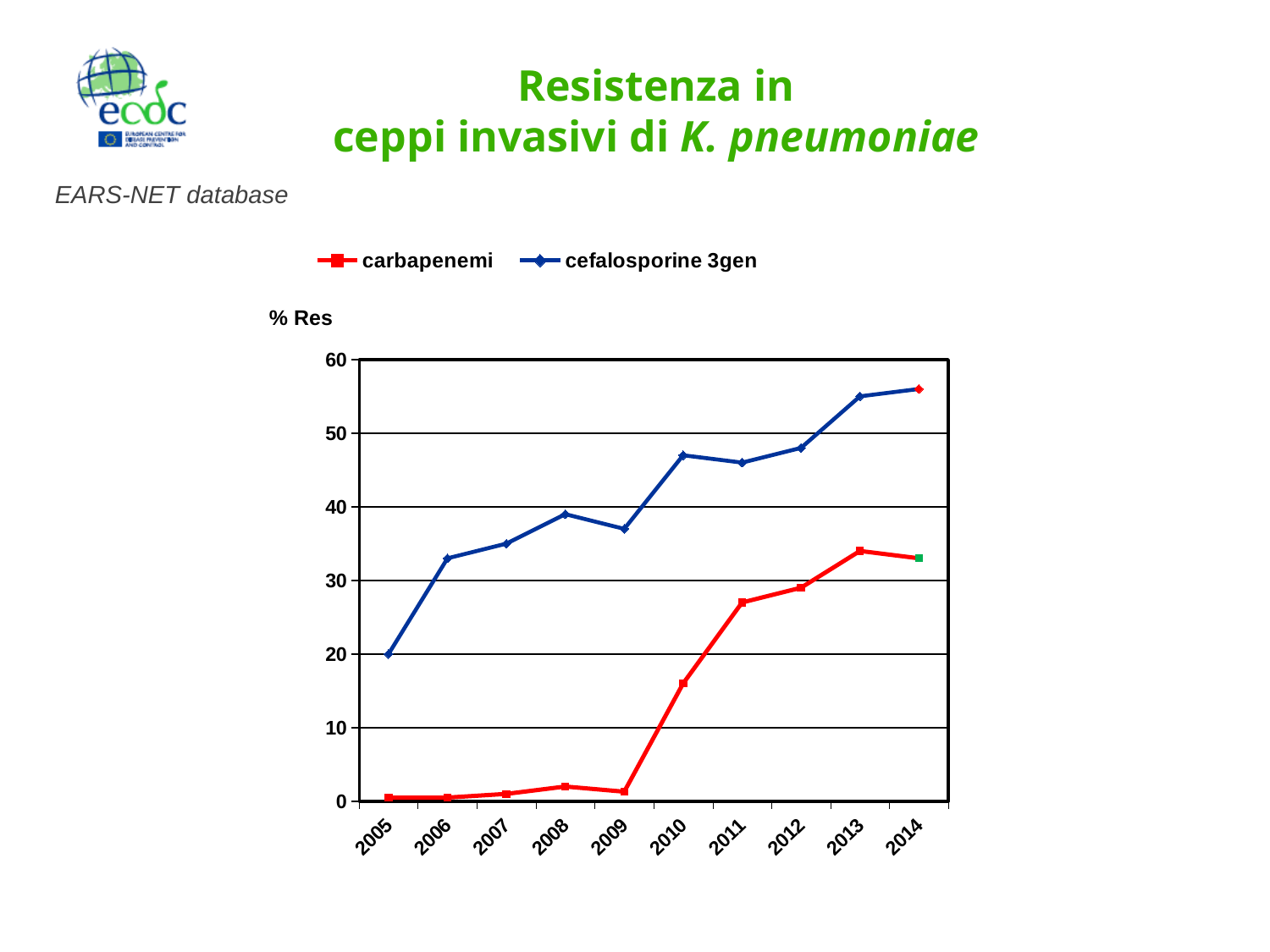
Is the value for cefalosporine 3gen in 2010 greater or less than 50? less Which two series are listed in the legend? carbapenemi and cefalosporine 3gen Does the value for cefalosporine 3gen generally rise or fall from 2005 to 2014? rise Is the value for cefalosporine 3gen in 2014 greater or less than 50? greater What is the label on the y axis? % Res Is the value for carbapenemi in 2013 greater or less than 30? greater How many series does the legend list? 2 What kind of chart is shown on the slide? line chart In which year is the value for cefalosporine 3gen lowest? 2005 In 2014, which series has the higher value, carbapenemi or cefalosporine 3gen? cefalosporine 3gen How many years are plotted along the x axis? 10